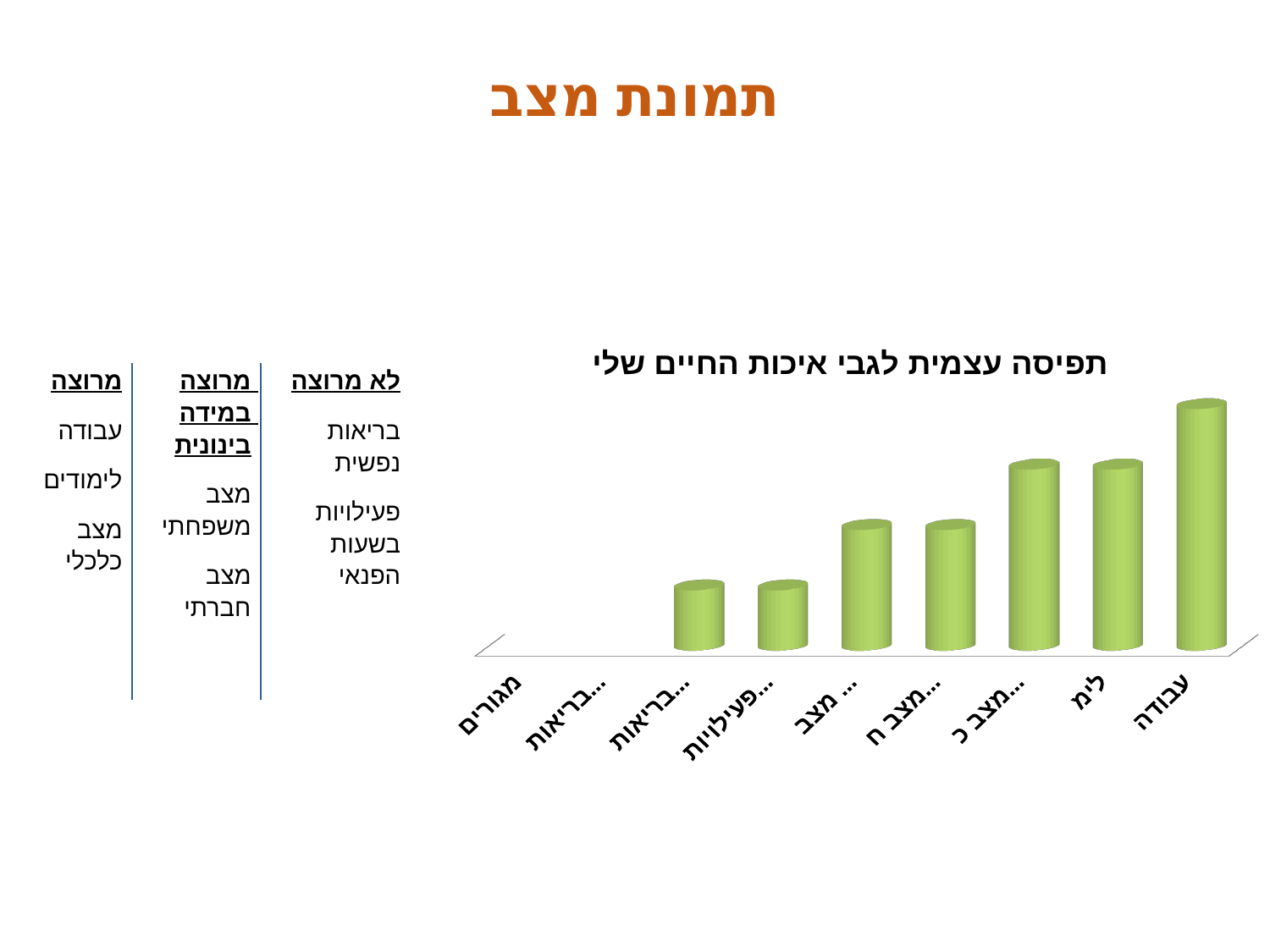
Which is larger, the value for עבודה or the value for the category labelled ...מצב כ? עבודה Which is larger, the value for עבודה or the value for מגורים? עבודה How many categories are shown on the x axis of the chart? 9 Which category has the highest bar in the chart? עבודה What colour are the bars in the chart? green What is the title of the chart? תפיסה עצמית לגבי איכות החיים שלי Which is larger, the value for the category labelled ...מצב כ or the value for the category labelled ...בריאות (second from the left)? ...מצב כ Do the bar values generally rise or fall from left to right along the x axis? rise Which category appears at the far right of the x axis? עבודה What kind of chart is shown on the slide? bar chart